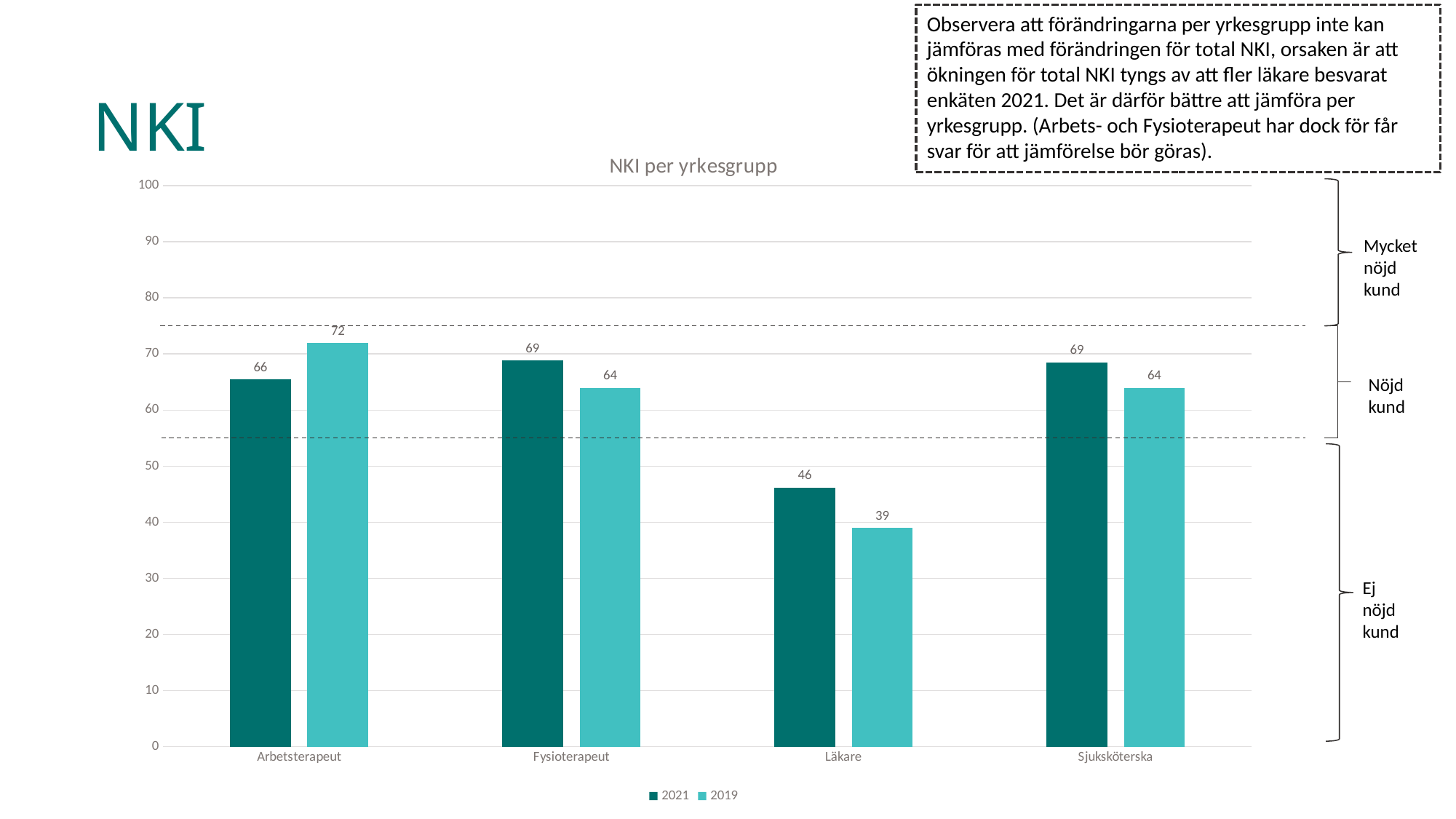
Which occupational group has the lowest NKI value in 2019? Läkare Is the 2021 value for Läkare greater or less than 50? less What is the NKI value for Arbetsterapeut in 2019? 72 Which occupational group has the highest NKI value in 2019? Arbetsterapeut How many occupational groups are shown on the x axis? 4 What is the difference between the 2019 and 2021 NKI values for Arbetsterapeut? 6 Which is larger for Fysioterapeut: the 2021 value or the 2019 value? 2021 How many series does the legend list? 2 What is the difference between the 2021 and 2019 NKI values for Läkare? 7 What type of chart is shown on the slide? bar chart What is the NKI value for Sjuksköterska in 2019? 64 What is the NKI value for Läkare in 2021? 46